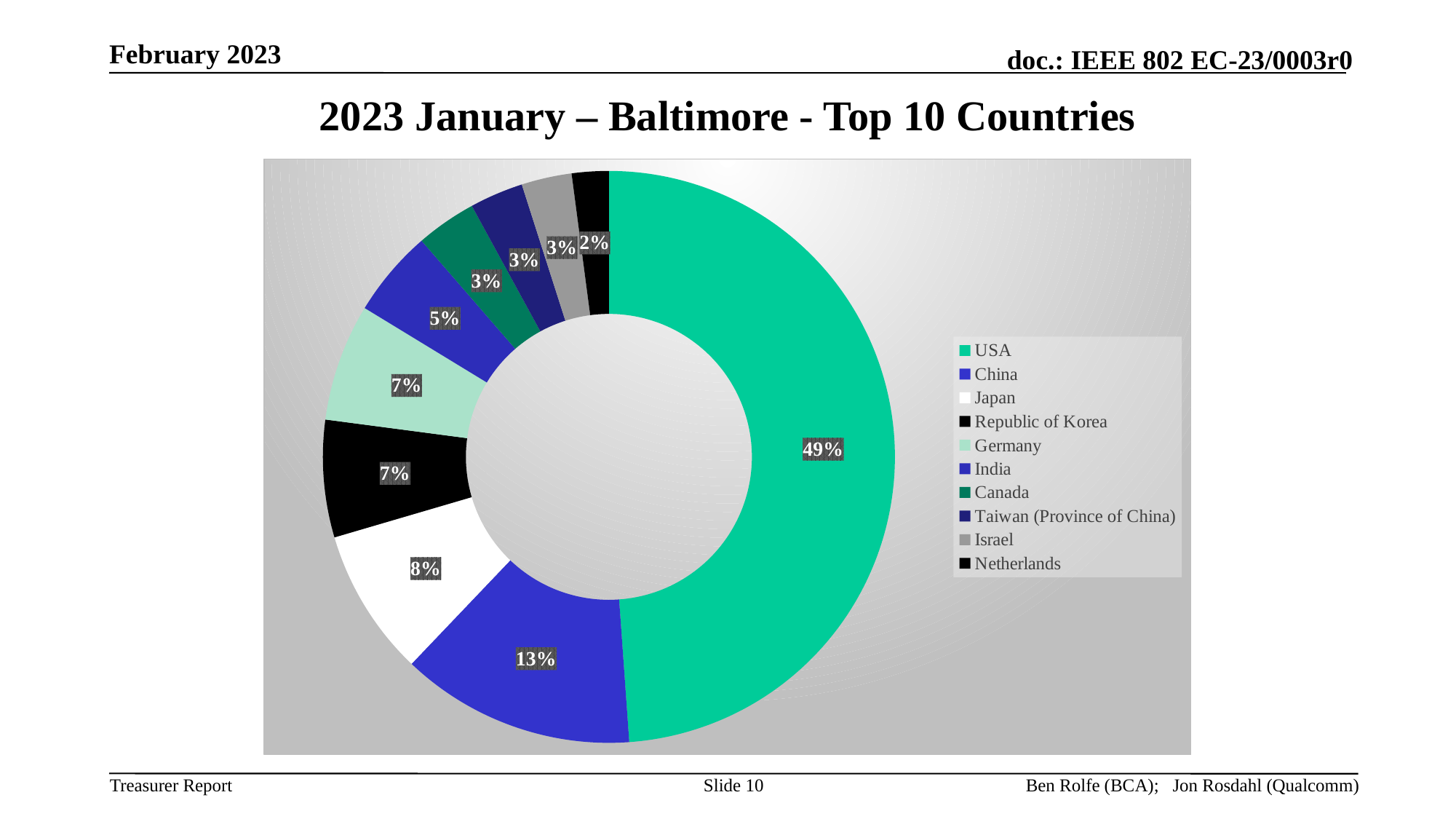
What is the value shown for Japan? 8% How many countries are shown in the chart? 10 What kind of chart is shown on the slide? doughnut chart What is the difference between the shares of USA and China? 36% What share of the chart does USA account for? 49% Which has a larger share, Japan or India? Japan What is the value shown for Germany? 7% What is the value shown for India? 5% What is the title of the slide containing the chart? 2023 January – Baltimore - Top 10 Countries Which country has the smallest share in the chart? Netherlands Which country has the largest share in the chart? USA What is the value shown for China? 13%